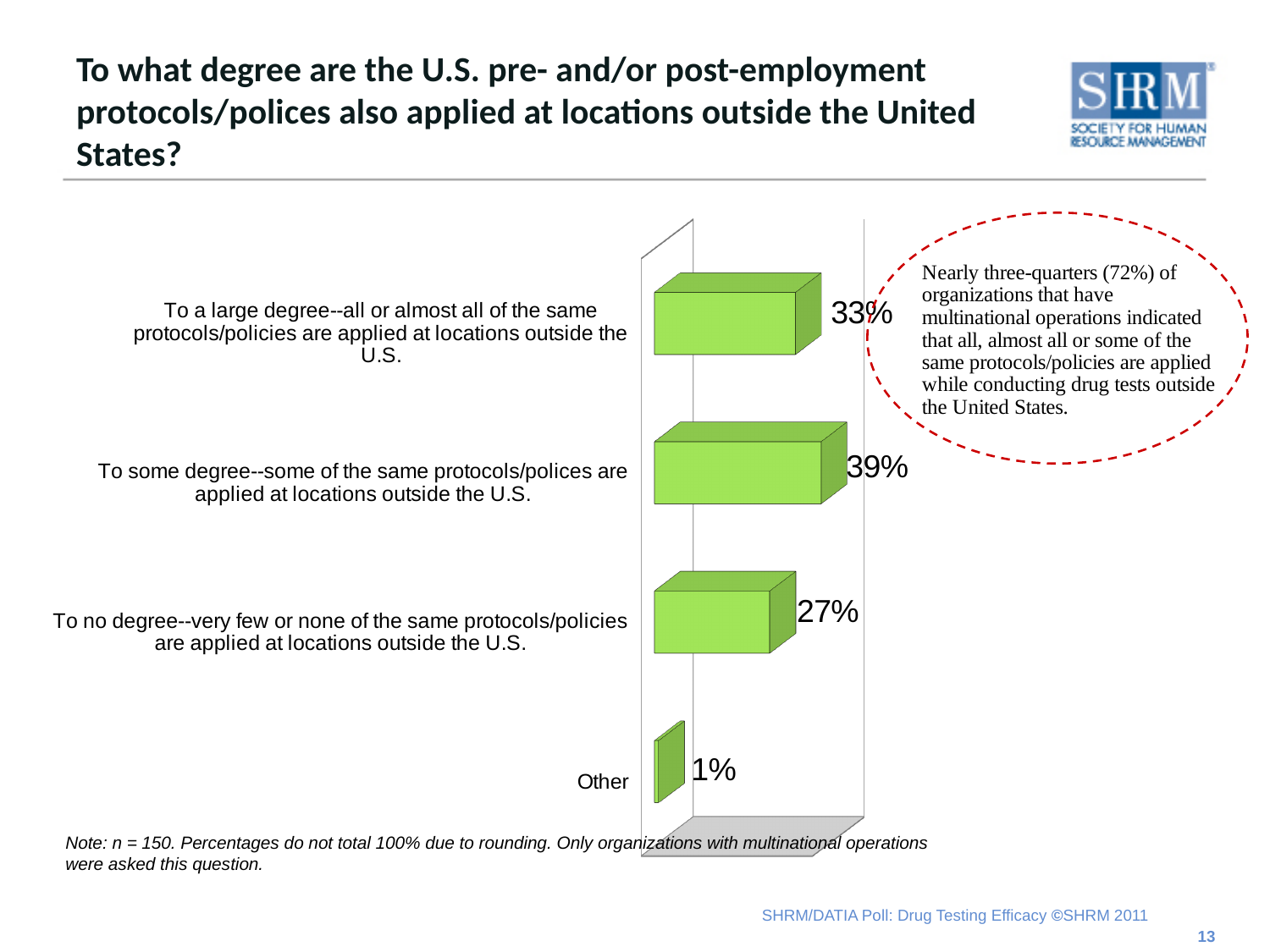
What is the difference in percentage points between "To some degree" and "To a large degree"? 6 What percentage of organizations answered "Other"? 1% Which category has the lowest percentage? Other What type of chart is shown on the slide? Bar chart What is the sample size (n) noted below the chart? 150 What percentage of organizations apply the same protocols/policies outside the U.S. to a large degree? 33% What percentage of organizations apply the same protocols/policies outside the U.S. to no degree? 27% How many categories are shown in the chart? 4 What is the difference in percentage points between "To no degree" and "Other"? 26 Which is larger: the percentage for "To a large degree" or for "To no degree"? To a large degree Which category has the highest percentage? To some degree--some of the same protocols/polices are applied at locations outside the U.S. What percentage of organizations apply the same protocols/policies outside the U.S. to some degree? 39%